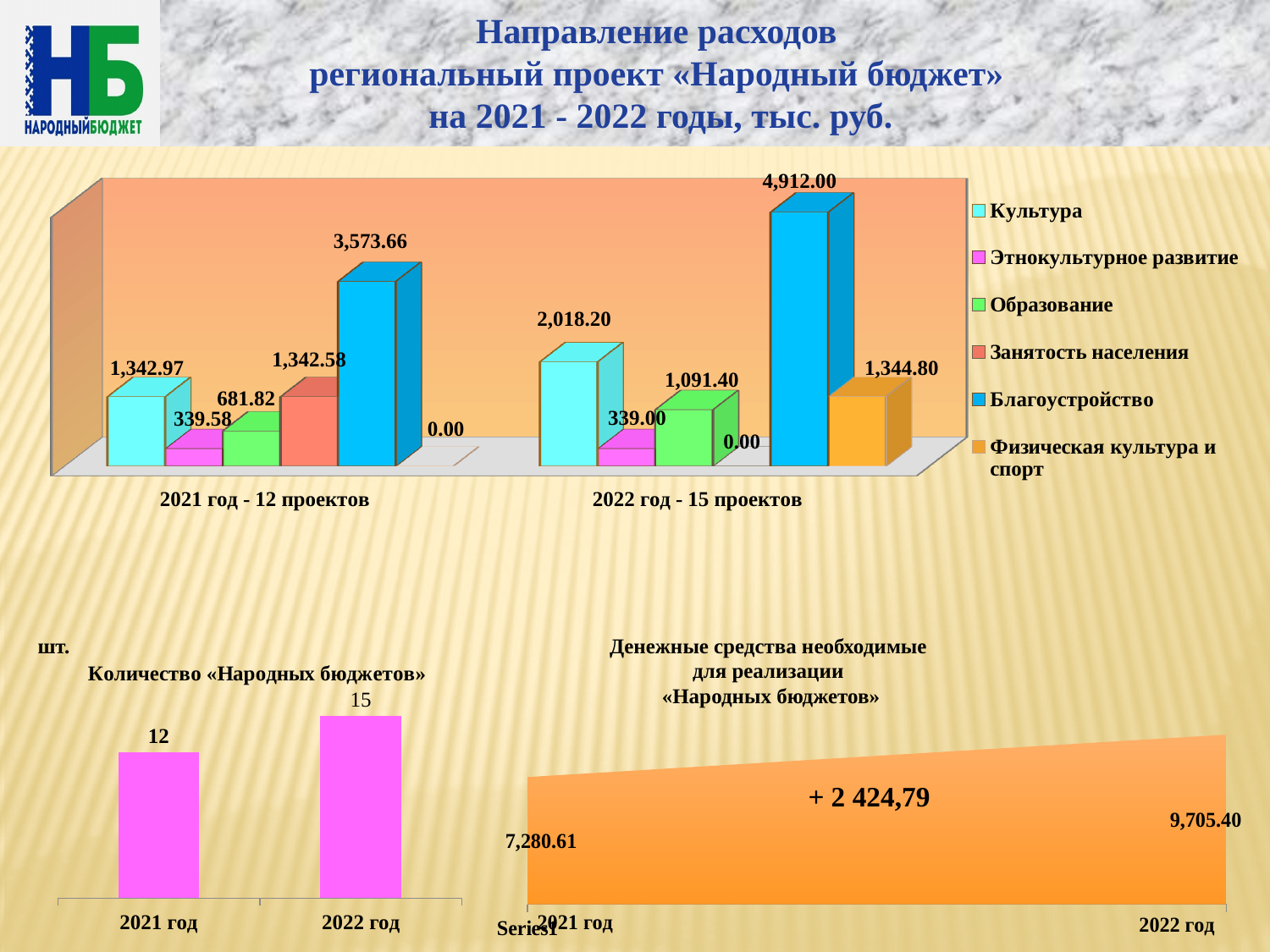
In the top chart, which colour represents Благоустройство? Blue In the top chart, what is the value for Образование in 2021 год - 12 проектов? 681.82 In the top chart, what is the value for Физическая культура и спорт in 2022 год - 15 проектов? 1,344.80 In the top chart, which series has the lowest value in 2022 год - 15 проектов? Занятость населения In the bottom-right chart (Денежные средства необходимые для реализации «Народных бюджетов»), what is the value for 2021 год? 7,280.61 How many series does the legend of the top chart list? 6 In the top chart, which is larger: Культура in 2021 or Культура in 2022? Культура in 2022 In the top chart, what is the value for Благоустройство in 2022 год - 15 проектов? 4,912.00 What kind of chart is the chart titled Количество «Народных бюджетов»? Bar chart In the chart titled Количество «Народных бюджетов», what is the value for 2022 год? 15 In the top chart, what is the difference between the Благоустройство values for 2022 and 2021? 1,338.34 In the top chart, which series has the highest value in 2021 год - 12 проектов? Благоустройство